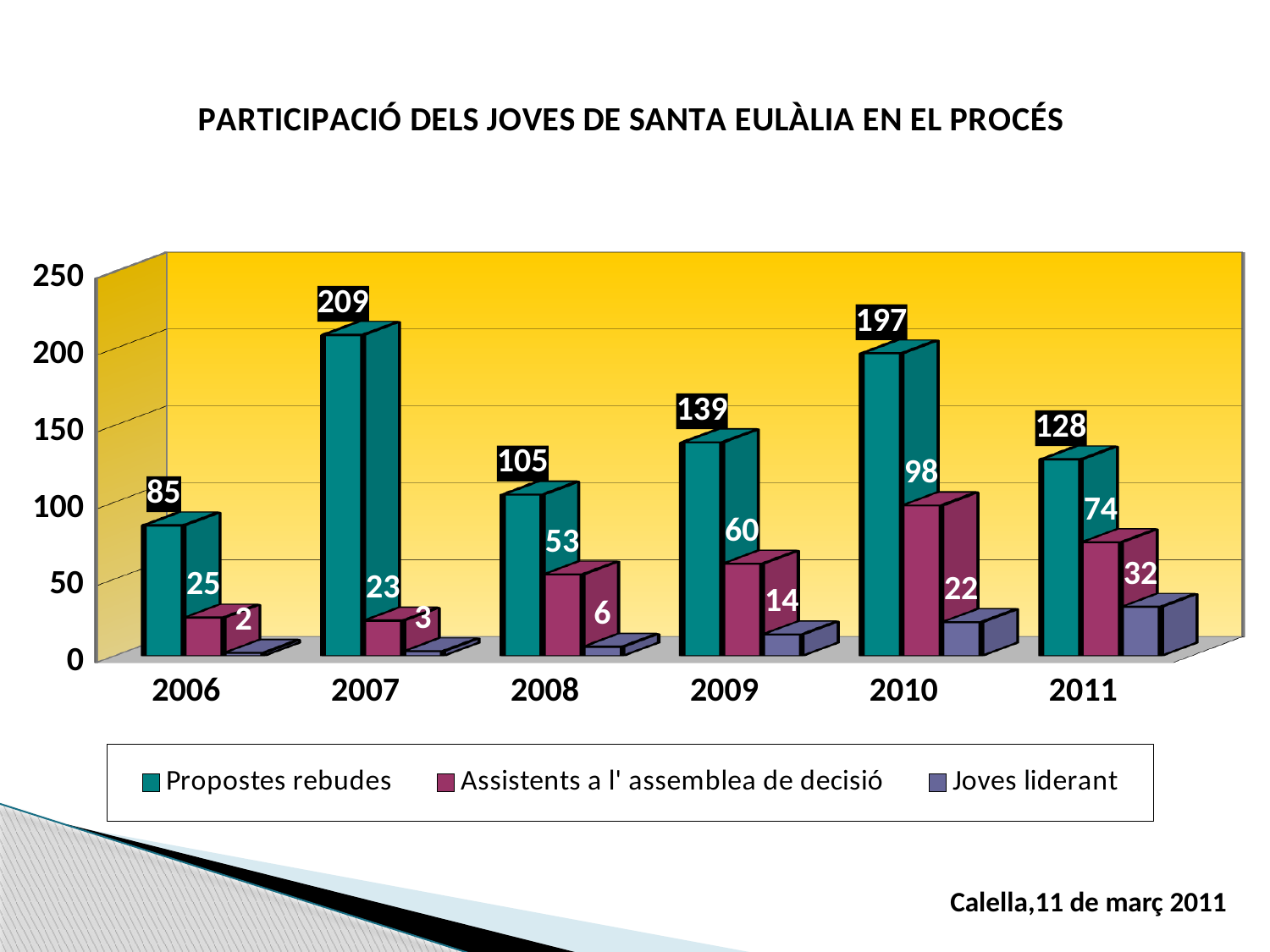
How many series does the legend list? 3 How many years are shown on the x axis? 6 What is the value of Propostes rebudes for 2007? 209 Which year has the lowest value for Joves liderant? 2006 What is the difference between Propostes rebudes in 2010 and in 2011? 69 What is the value of Assistents a l' assemblea de decisió for 2010? 98 Which year has the highest value for Propostes rebudes? 2007 Which is larger: Assistents a l' assemblea de decisió in 2008 or in 2009? 2009 What is the value of Joves liderant for 2011? 32 What kind of chart is shown on the slide? bar chart Does the Joves liderant series rise or fall from 2006 to 2011? rise Is the value of Propostes rebudes for 2009 greater or less than 100? greater